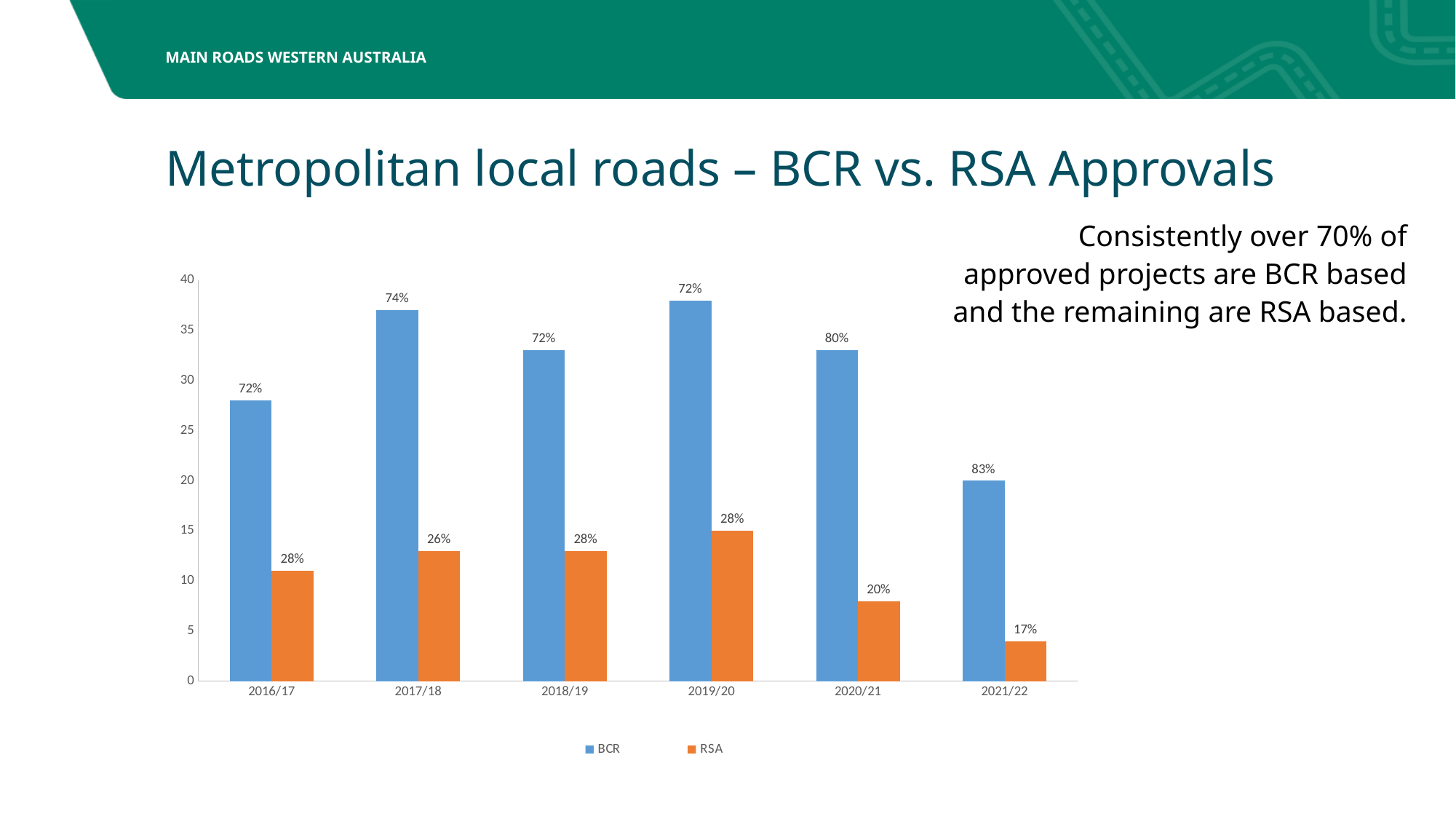
What percentage label is shown on the RSA bar for 2020/21? 20% How many years are shown on the x axis? 6 How many series does the legend list? 2 Which year has the lowest RSA bar? 2021/22 Is the value for the RSA bar in 2020/21 greater or less than 10? less What kind of chart is shown on the slide? Bar chart What percentage label is shown on the RSA bar for 2017/18? 26% What percentage label is shown on the BCR bar for 2021/22? 83% In 2019/20, which bar is taller, BCR or RSA? BCR Is the value for the BCR bar in 2016/17 greater or less than 25? greater What is the difference between the BCR and RSA percentage labels for 2021/22? 66 percentage points Which year has the highest percentage label on its BCR bar? 2021/22